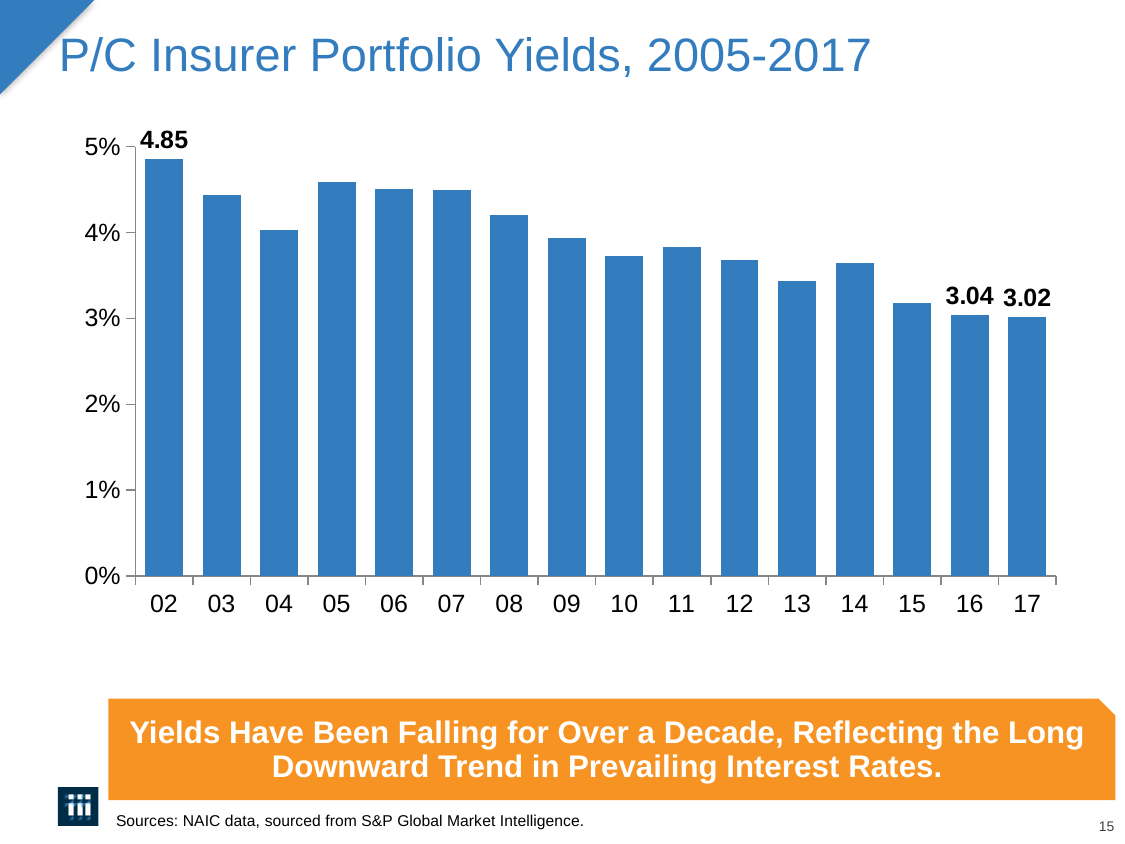
How many years are shown on the x axis? 16 Is the value for 13 greater or less than 4%? less What is the portfolio yield shown for 17? 3.02 Which year has the larger yield, 16 or 17? 16 What is the portfolio yield shown for 02? 4.85 What kind of chart is shown on the slide? bar chart Do the yields generally rise or fall from 02 to 17? fall What is the difference between the yield for 02 and the yield for 17? 1.83 What is the portfolio yield shown for 16? 3.04 Which year has the lowest portfolio yield? 17 Is the value for 05 greater or less than 4%? greater Which year has the highest portfolio yield? 02